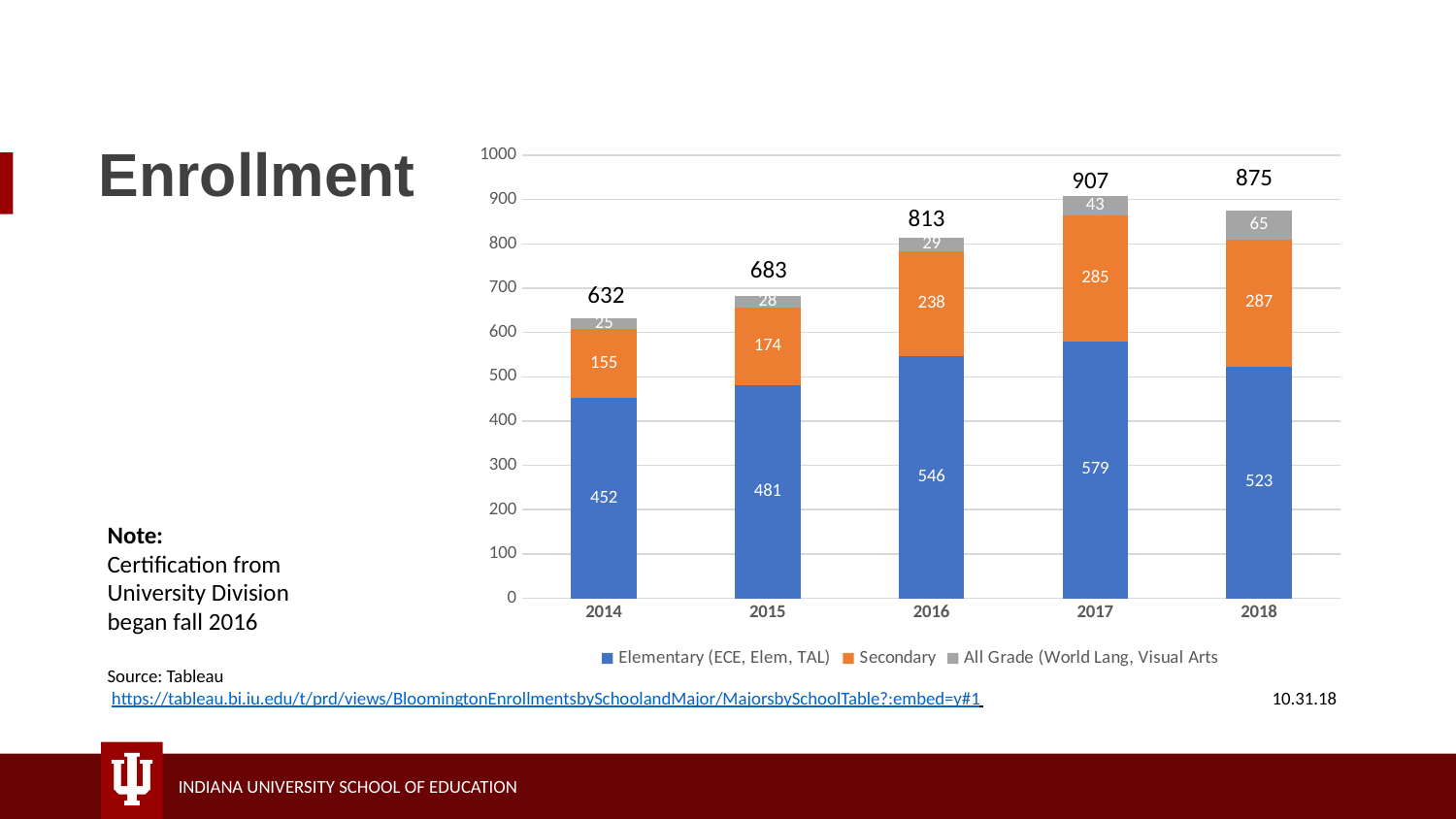
What is the total enrollment shown above the 2015 bar? 683 What is the Secondary enrollment for 2017? 285 Which year has the highest total enrollment? 2017 What kind of chart is shown on the slide? Stacked bar chart How many years are shown on the x axis? 5 Which colour represents the Secondary series in the chart? Orange What is the difference between the total enrollment in 2017 and in 2018? 32 Which is larger, the Secondary enrollment in 2016 or in 2015? 2016 Which year has the lowest Elementary (ECE, Elem, TAL) enrollment? 2014 What is the Elementary (ECE, Elem, TAL) enrollment for 2016? 546 What is the All Grade (World Lang, Visual Arts) enrollment for 2018? 65 How many series does the legend list? 3